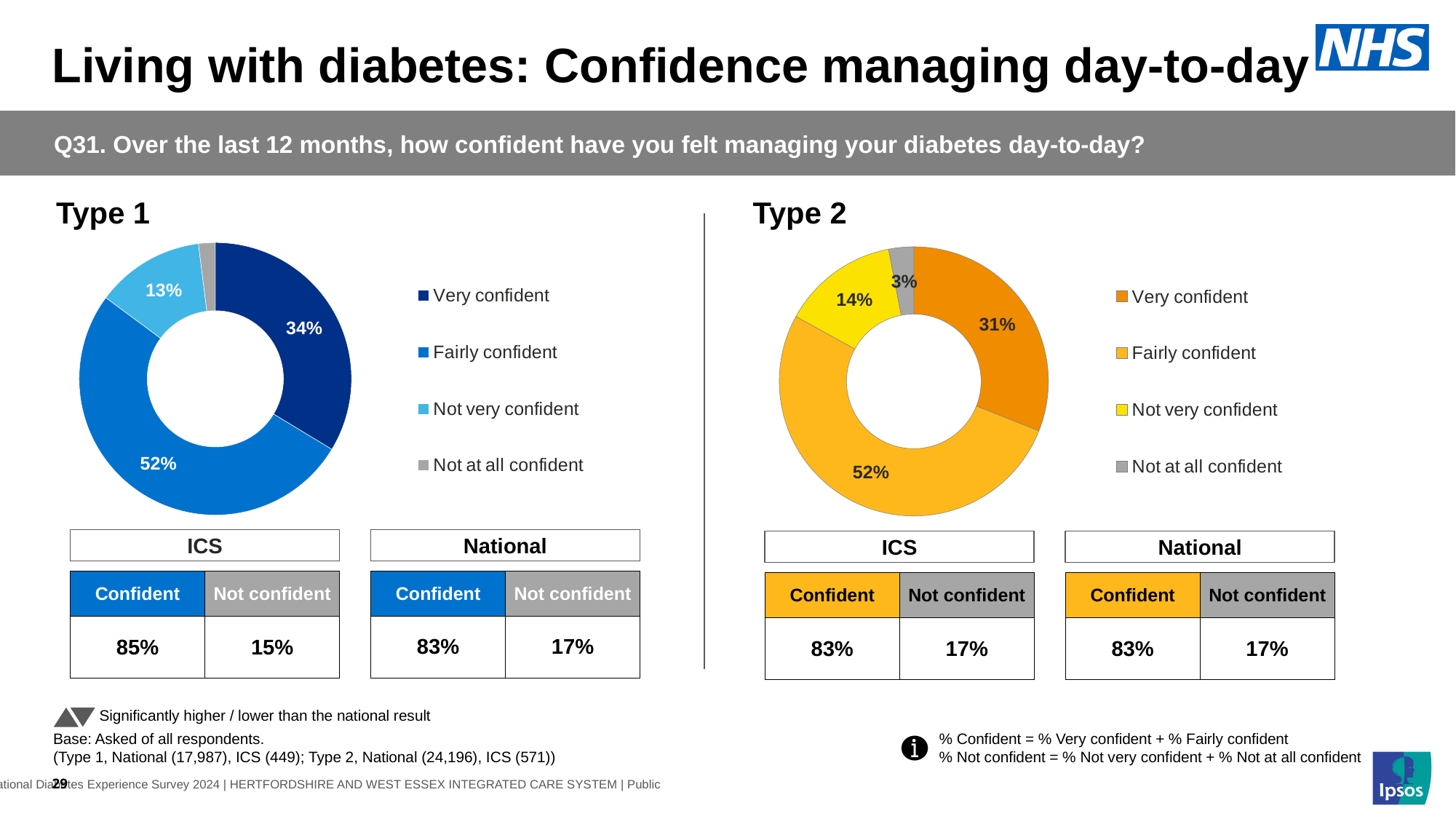
In the Type 2 chart, what colour is the fairly confident slice? Orange/yellow In the Type 2 chart, what percentage of respondents were not at all confident? 3% In the Type 1 chart, which is larger: the share for very confident or the share for not very confident? Very confident How many categories does the legend of the Type 2 chart list? 4 In the Type 1 chart, what percentage of respondents were not very confident? 13% In the Type 1 chart, what percentage of respondents were fairly confident? 52% In the Type 2 chart, which category has the largest share? Fairly confident In the Type 1 chart, which category has the smallest share? Not at all confident In the Type 2 chart, what is the difference between the fairly confident and very confident shares? 21 percentage points In the Type 1 chart, what percentage of respondents were very confident? 34% In the Type 2 chart, what percentage of respondents were very confident? 31% What kind of chart is used for Type 1? Donut (pie) chart